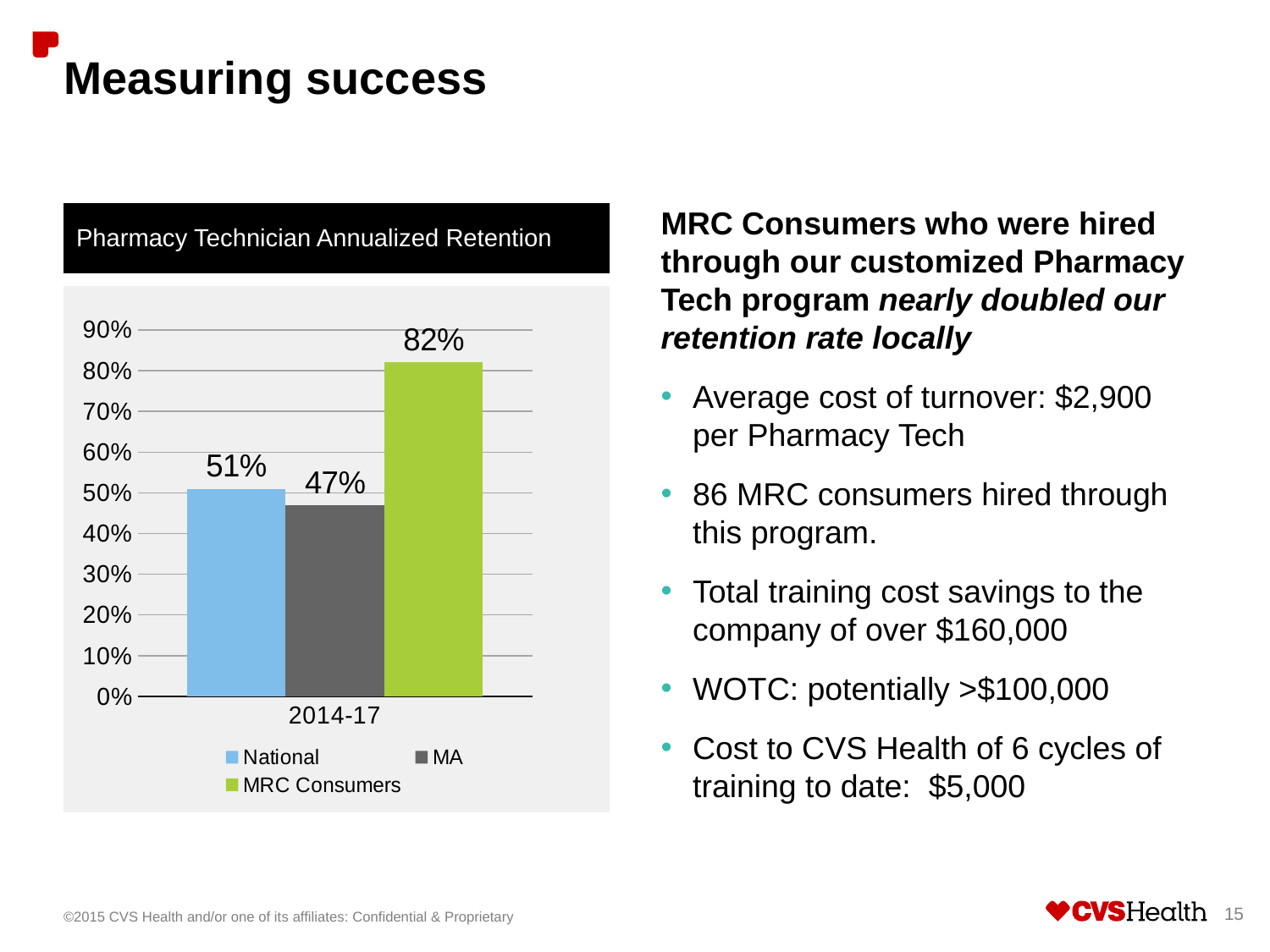
How many series does the legend list? 3 Which is larger, the retention rate for National or for MA? National What is the retention rate for MA in the chart? 47% Which series has the lowest retention rate in the chart? MA What is the difference between the National and MA retention rates? 4% What kind of chart is shown on the slide? Bar chart What is the difference between the MRC Consumers and National retention rates? 31% What is the retention rate for MRC Consumers in the chart? 82% Is the retention rate for MRC Consumers greater or less than 80%? greater Which series has the highest retention rate in the chart? MRC Consumers What is the title of the chart? Pharmacy Technician Annualized Retention What is the retention rate for National in the Pharmacy Technician Annualized Retention chart? 51%